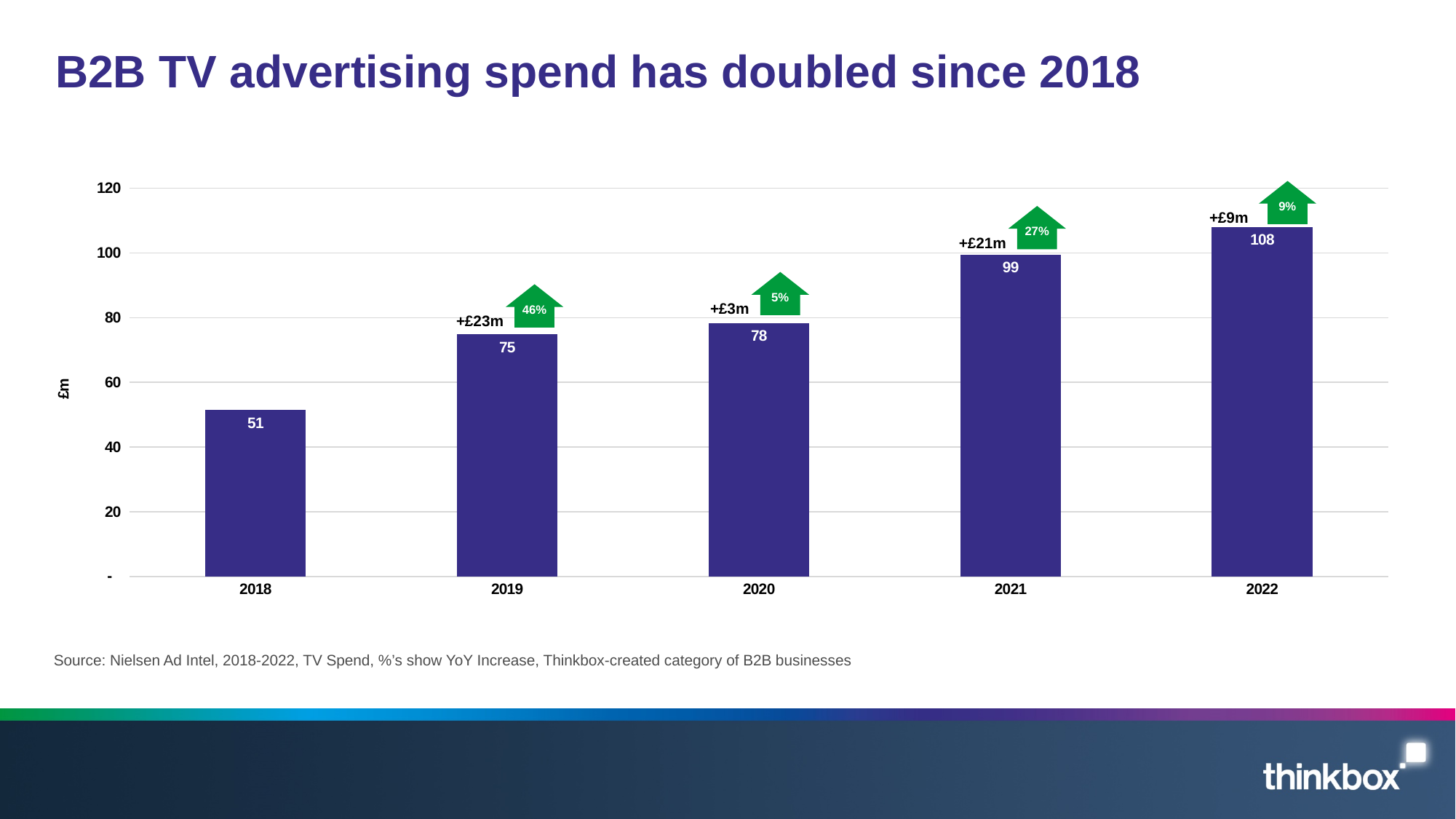
Which year has the lowest value? 2018 What is the value for 2020? 78 What is the value for 2022? 108 What is the value for 2018? 51 What is the difference between the values for 2021 and 2019? 24 Do the values rise or fall from 2018 to 2022? rise Which year has the highest value? 2022 Which is larger, the value for 2020 or the value for 2021? 2021 Is the value for 2022 greater or less than 100? greater How many years are shown on the x axis? 5 What percentage increase is shown in the green arrow above the 2019 bar? 46% What kind of chart is shown? bar chart